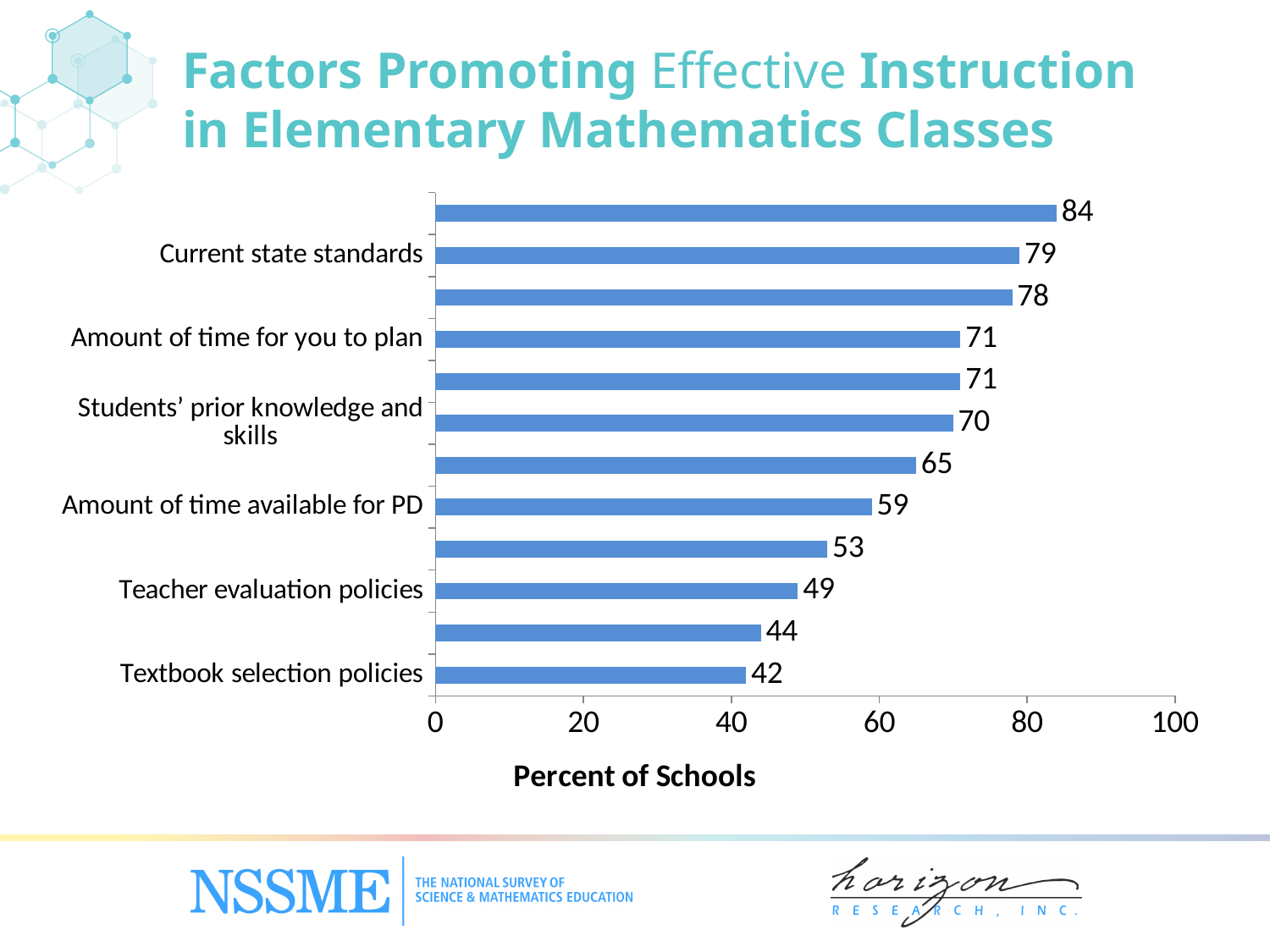
What is the value for Teacher evaluation policies? 49 What is the highest value shown on the chart? 84 What is the difference between the values for Current state standards and Textbook selection policies? 37 What kind of chart is shown on the slide? Bar chart What is the value for Amount of time for you to plan? 71 What is the title of the horizontal axis? Percent of Schools Which labeled category has the lowest value? Textbook selection policies What is the value for Current state standards? 79 How many bars are plotted on the chart? 12 What is the value for Amount of time available for PD? 59 Which is larger, the value for Amount of time available for PD or the value for Teacher evaluation policies? Amount of time available for PD What is the value for Students' prior knowledge and skills? 70